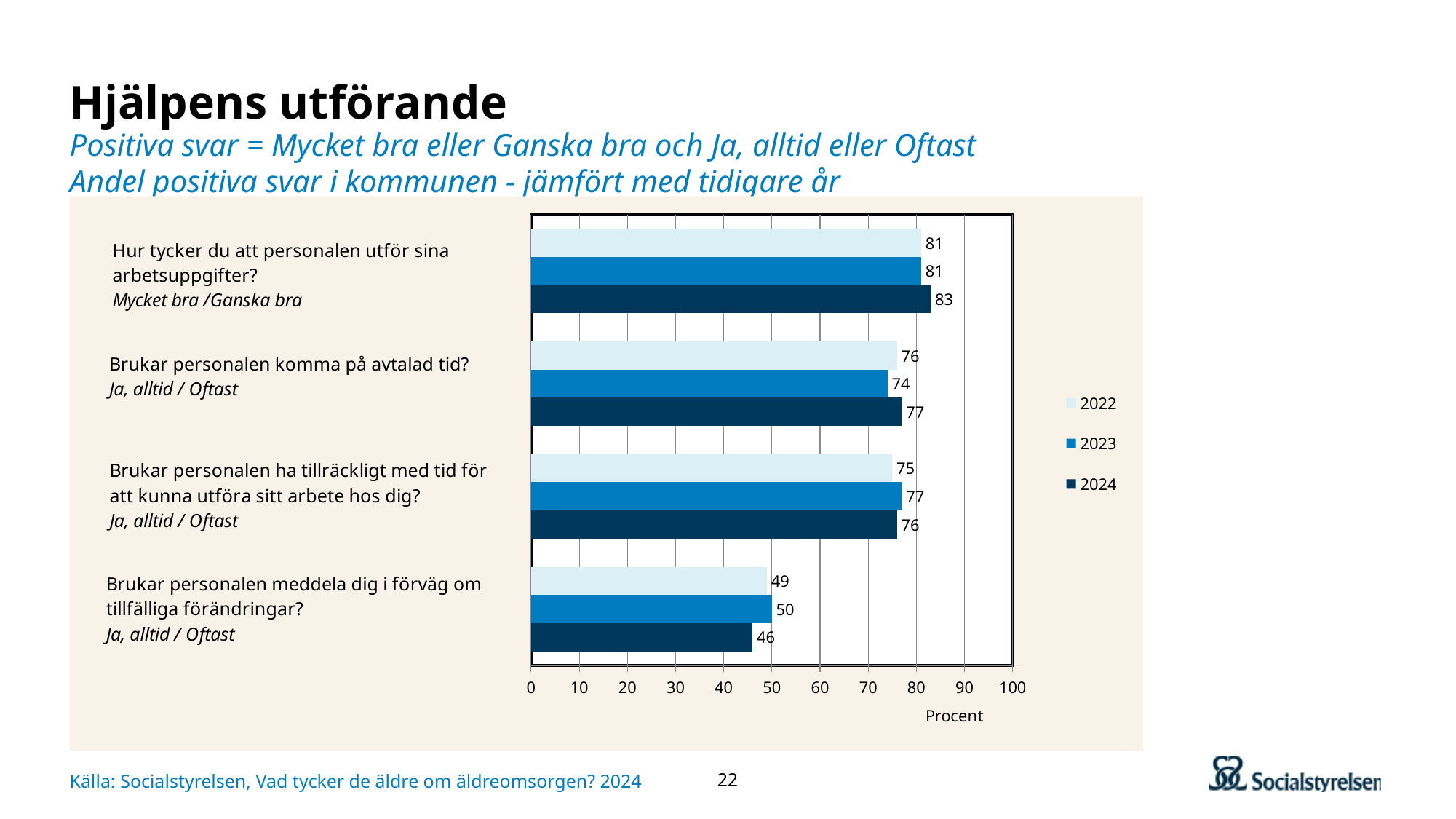
What label is shown on the horizontal axis of the chart? Procent Is the 2024 value for "Brukar personalen komma på avtalad tid?" greater or less than 70? greater Which question category has the highest 2022 value? Hur tycker du att personalen utför sina arbetsuppgifter? How many question categories are plotted in the chart? 4 How many series does the legend list? 3 What is the 2024 value for "Hur tycker du att personalen utför sina arbetsuppgifter?"? 83 For "Brukar personalen ha tillräckligt med tid för att kunna utföra sitt arbete hos dig?", which year has the larger value, 2022 or 2023? 2023 Which question category has the lowest 2024 value? Brukar personalen meddela dig i förväg om tillfälliga förändringar? What type of chart is shown on the slide? Bar chart What is the 2023 value for "Brukar personalen komma på avtalad tid?"? 74 What is the difference between the 2023 and 2024 values for "Brukar personalen meddela dig i förväg om tillfälliga förändringar?"? 4 What is the 2022 value for "Brukar personalen meddela dig i förväg om tillfälliga förändringar?"? 49